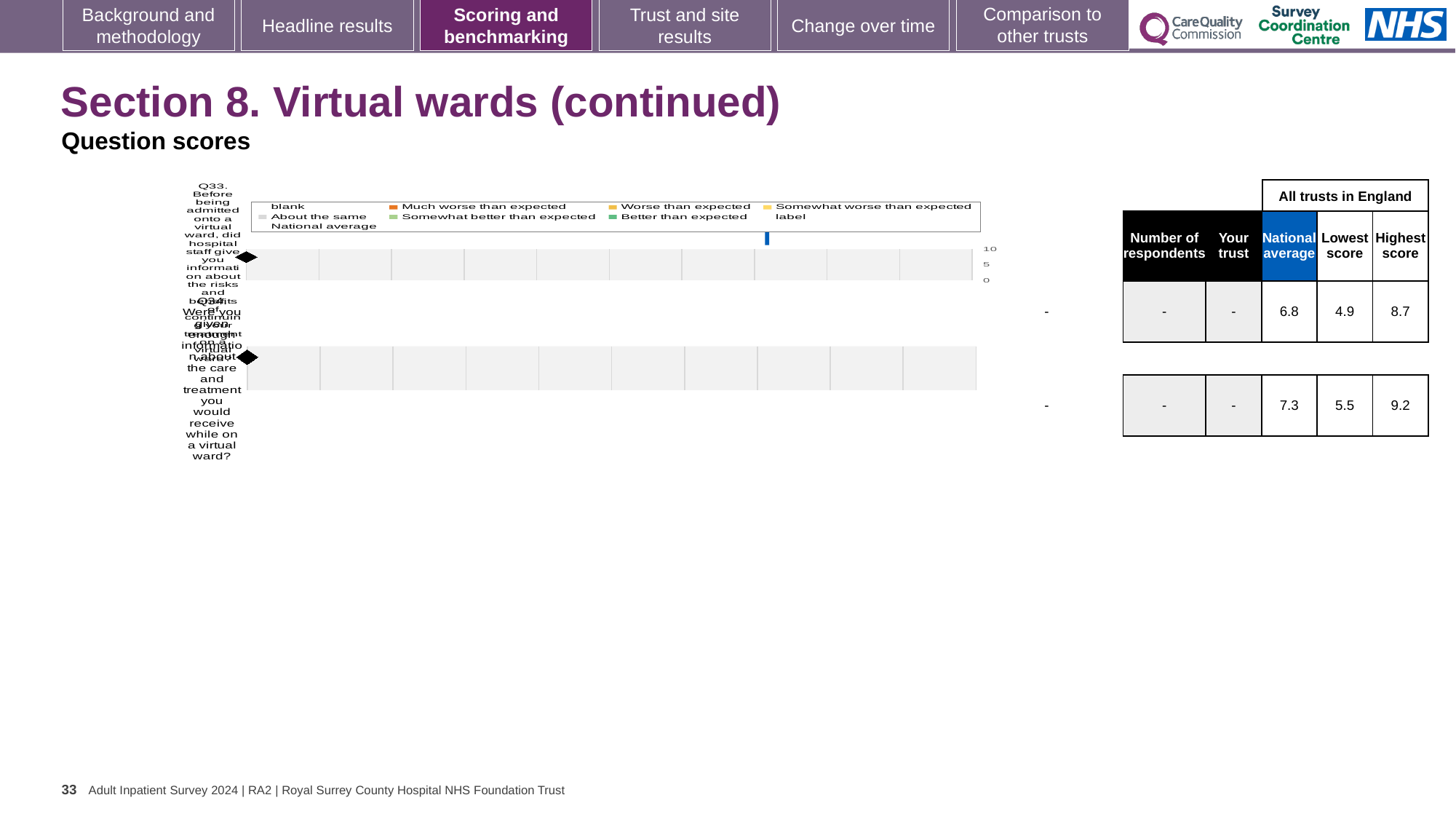
In the table, what is the difference between the highest and lowest scores for Q33? 3.8 In the table, what is the lowest score for Q33? 4.9 In the table, what is the national average score for Q34? 7.3 In the table, what is the national average score for Q33? 6.8 Which question numbers are plotted as the two rows of the chart? Q33 and Q34 In the table, what value is shown for 'Your trust' for Q33? - In the table, what is the highest score for Q34? 9.2 What is the maximum value shown on the chart's horizontal axis? 10 In the table, what is the difference between the highest and lowest scores for Q34? 3.7 What kind of chart is shown on the slide? bar chart How many question categories (rows) does the chart show? 2 In the table, which question has the higher national average, Q33 or Q34? Q34